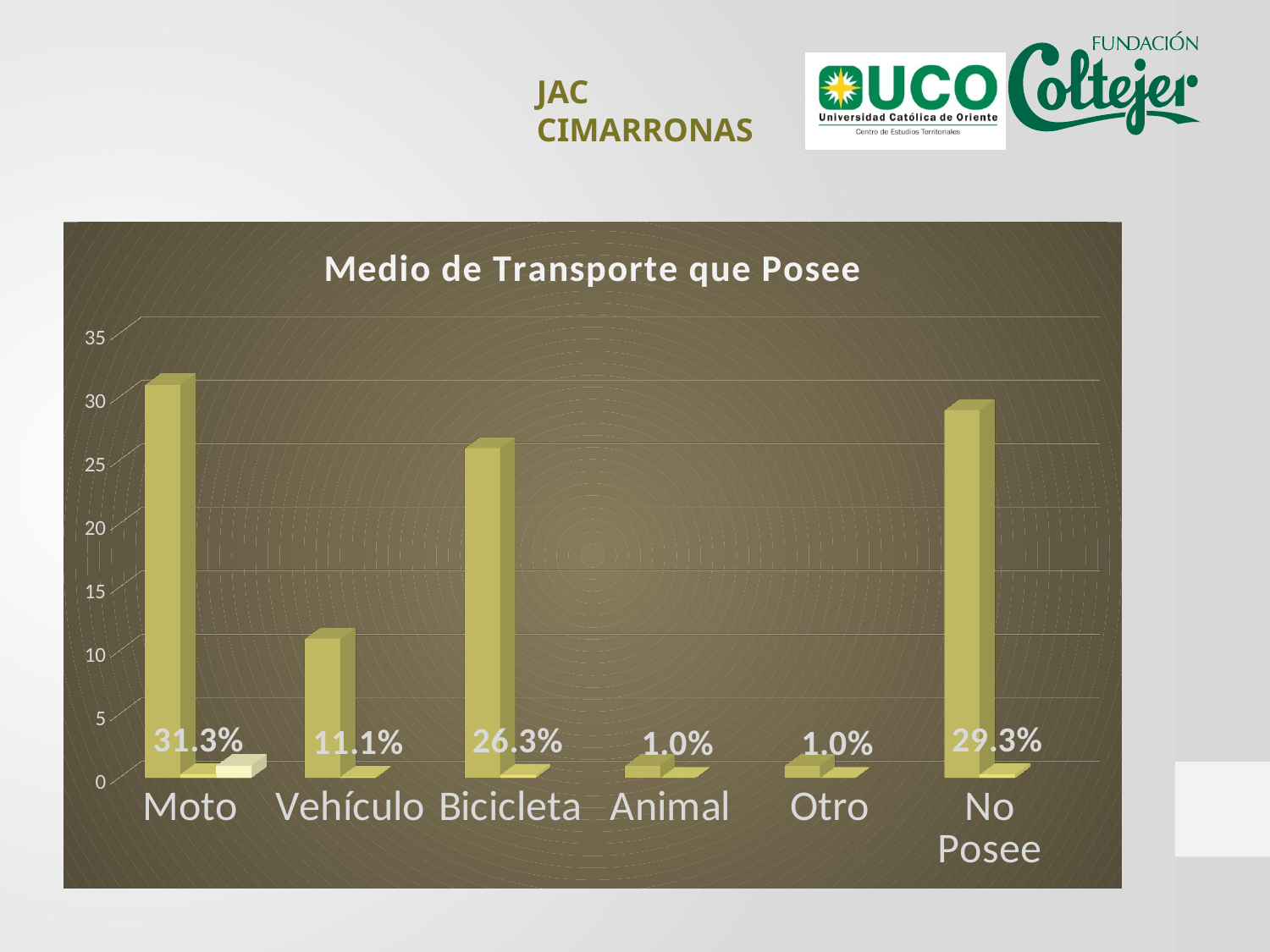
What is the value for Moto in the chart? 31.3% What is the difference between the values for Bicicleta and Vehículo? 15.2% Is the value for Vehículo greater or less than 15? less What kind of chart is shown on the slide? bar chart What is the value for Vehículo in the chart? 11.1% Which is larger, the value for Bicicleta or the value for Vehículo? Bicicleta How many categories are shown in the chart? 6 Which category has the highest value in the chart? Moto What is the value for No Posee in the chart? 29.3% What is the value for Bicicleta in the chart? 26.3% What is the title of the chart? Medio de Transporte que Posee What is the difference between the values for Moto and No Posee? 2.0%